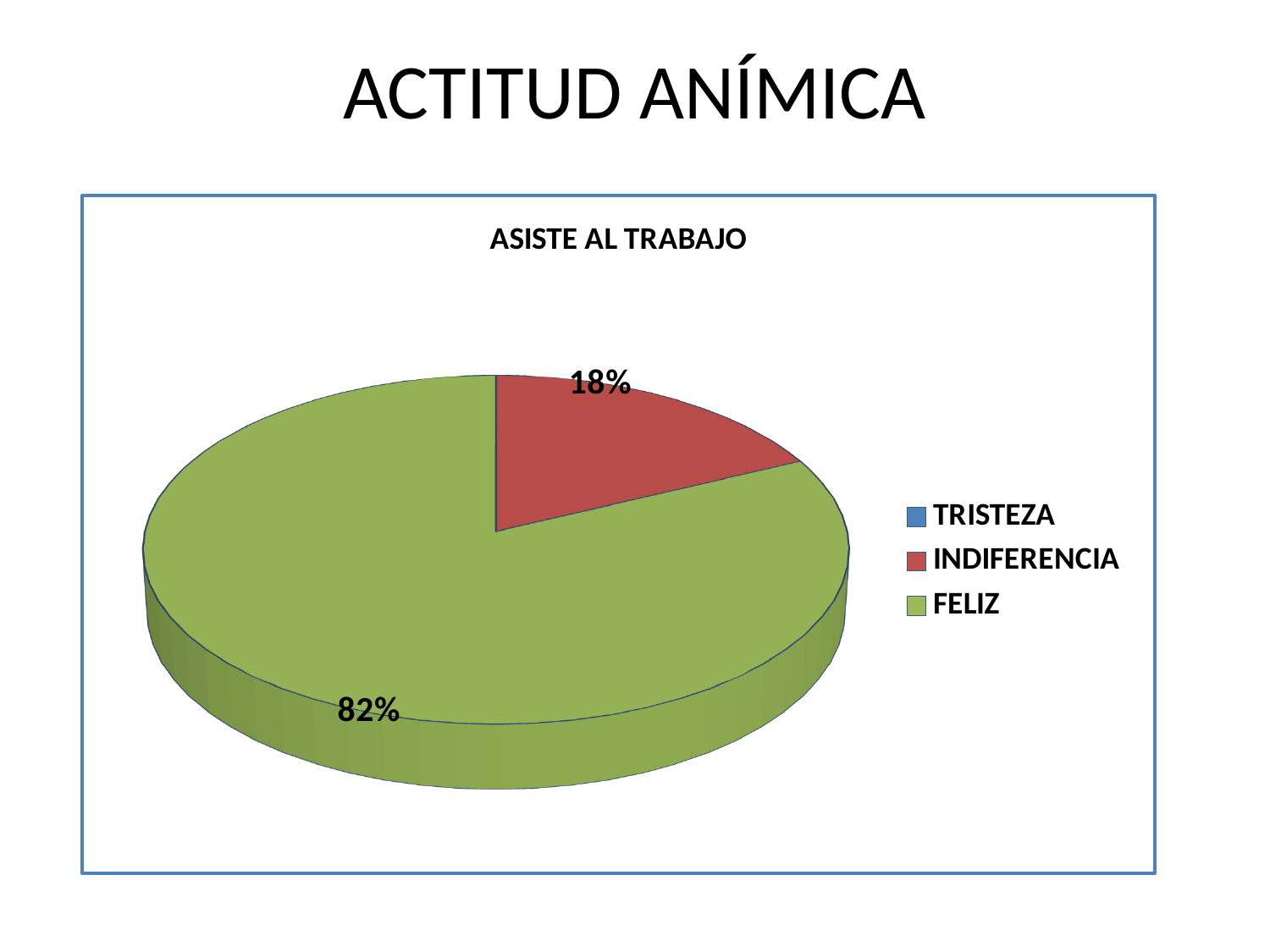
What percentage does the FELIZ slice show? 82% What is the difference in percentage points between the FELIZ slice and the INDIFERENCIA slice? 64 percentage points Which is larger, the FELIZ slice or the INDIFERENCIA slice? FELIZ How many slices with printed percentage labels are visible in the pie? 2 Is the value for INDIFERENCIA greater or less than 50%? less What is the title of the chart? ASISTE AL TRABAJO What percentage does the INDIFERENCIA slice show? 18% How many entries does the chart legend list? 3 Which category has the largest slice of the pie? FELIZ What share of the pie does the FELIZ slice represent? 82% What kind of chart is shown on the slide? Pie chart What colour is the FELIZ slice? Green